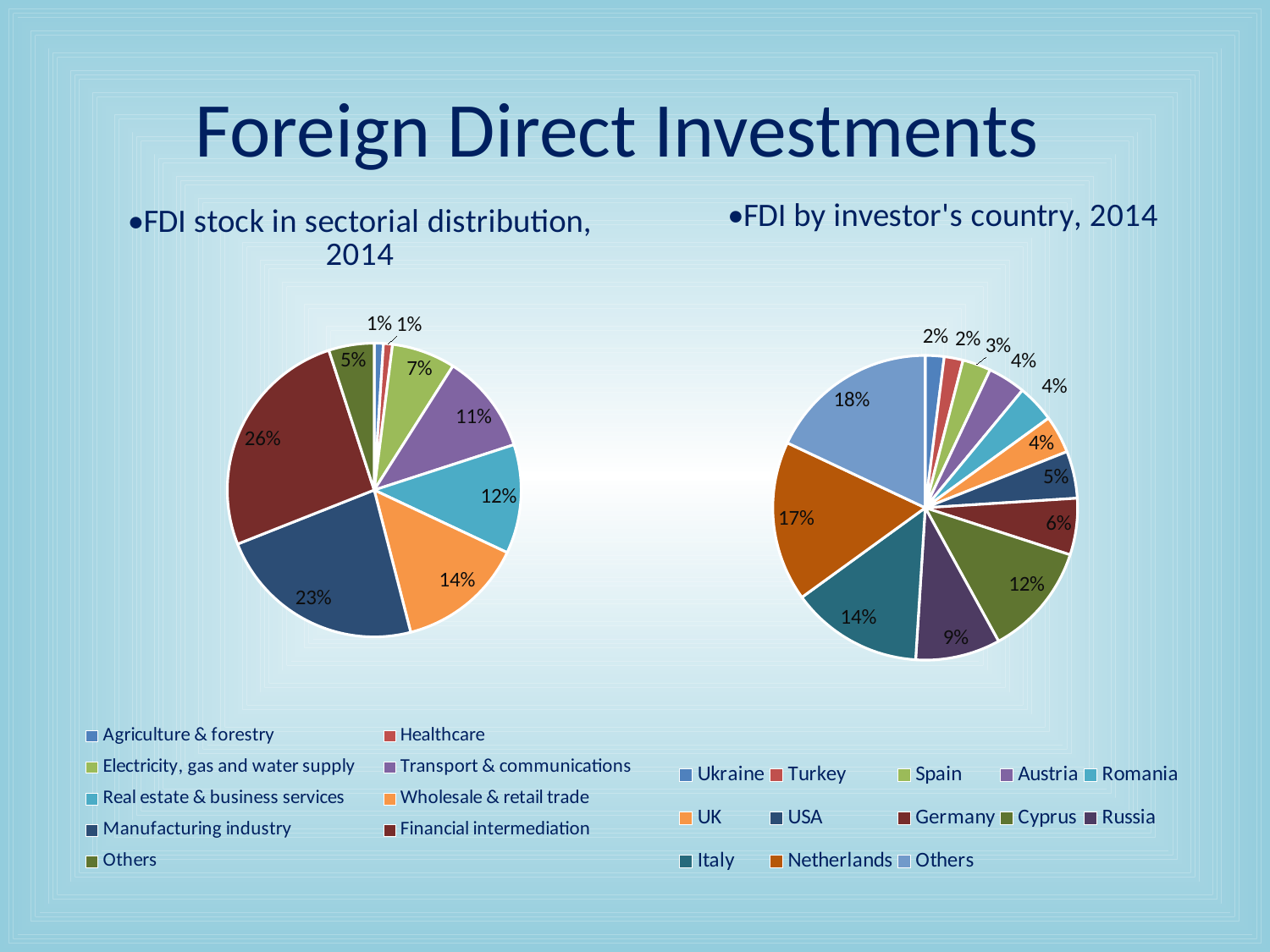
In the 'FDI by investor's country, 2014' chart, what is the difference between the shares of Italy and Russia? 5% How many countries or categories are listed in the legend of the 'FDI by investor's country, 2014' chart? 13 In the 'FDI stock in sectorial distribution, 2014' chart, what share does Transport & communications have? 11% In the 'FDI stock in sectorial distribution, 2014' chart, what share does Manufacturing industry have? 23% In the 'FDI stock in sectorial distribution, 2014' chart, which sector has the largest share? Financial intermediation How many sectors are shown in the 'FDI stock in sectorial distribution, 2014' chart? 9 In the 'FDI by investor's country, 2014' chart, what share does Netherlands have? 17% In the 'FDI stock in sectorial distribution, 2014' chart, what is the difference between the shares of Financial intermediation and Wholesale & retail trade? 12% In the 'FDI stock in sectorial distribution, 2014' chart, which has a larger share: Real estate & business services or Electricity, gas and water supply? Real estate & business services In the 'FDI by investor's country, 2014' chart, what share does Cyprus have? 12% In the 'FDI by investor's country, 2014' chart, which category has the largest share? Others What type of chart is used for 'FDI by investor's country, 2014'? Pie chart